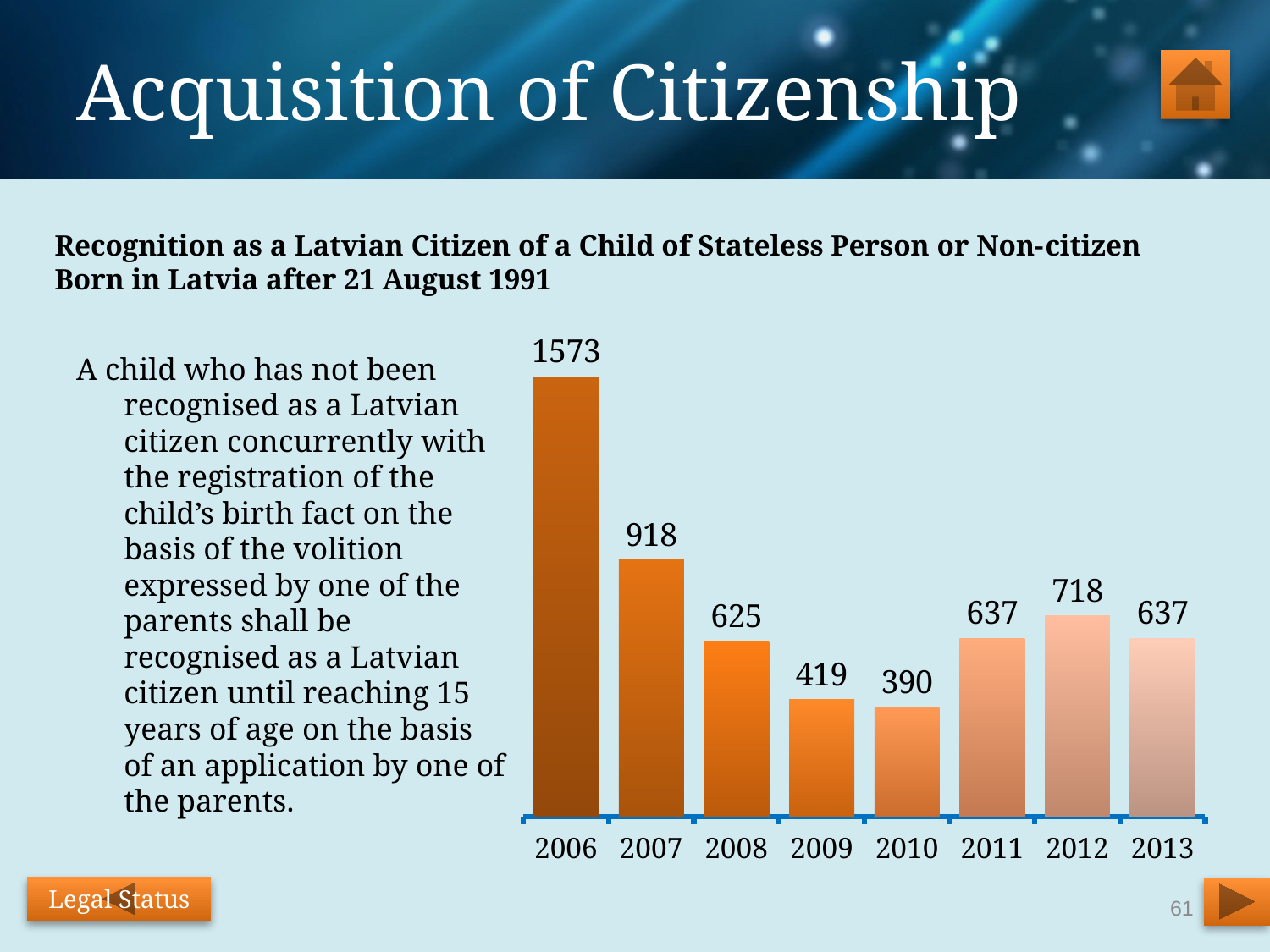
Do the values rise or fall from 2006 to 2010? fall What is the difference between the values for 2012 and 2011? 81 Which year has the lowest value? 2010 Which two years have the same value of 637? 2011 and 2013 What is the value for 2012? 718 What is the value for 2010? 390 What is the difference between the values for 2006 and 2007? 655 Which is larger, the value for 2008 or the value for 2009? 2008 How many years are shown on the chart? 8 What is the value for 2006? 1573 Which year has the highest value? 2006 What kind of chart is shown on the slide? bar chart